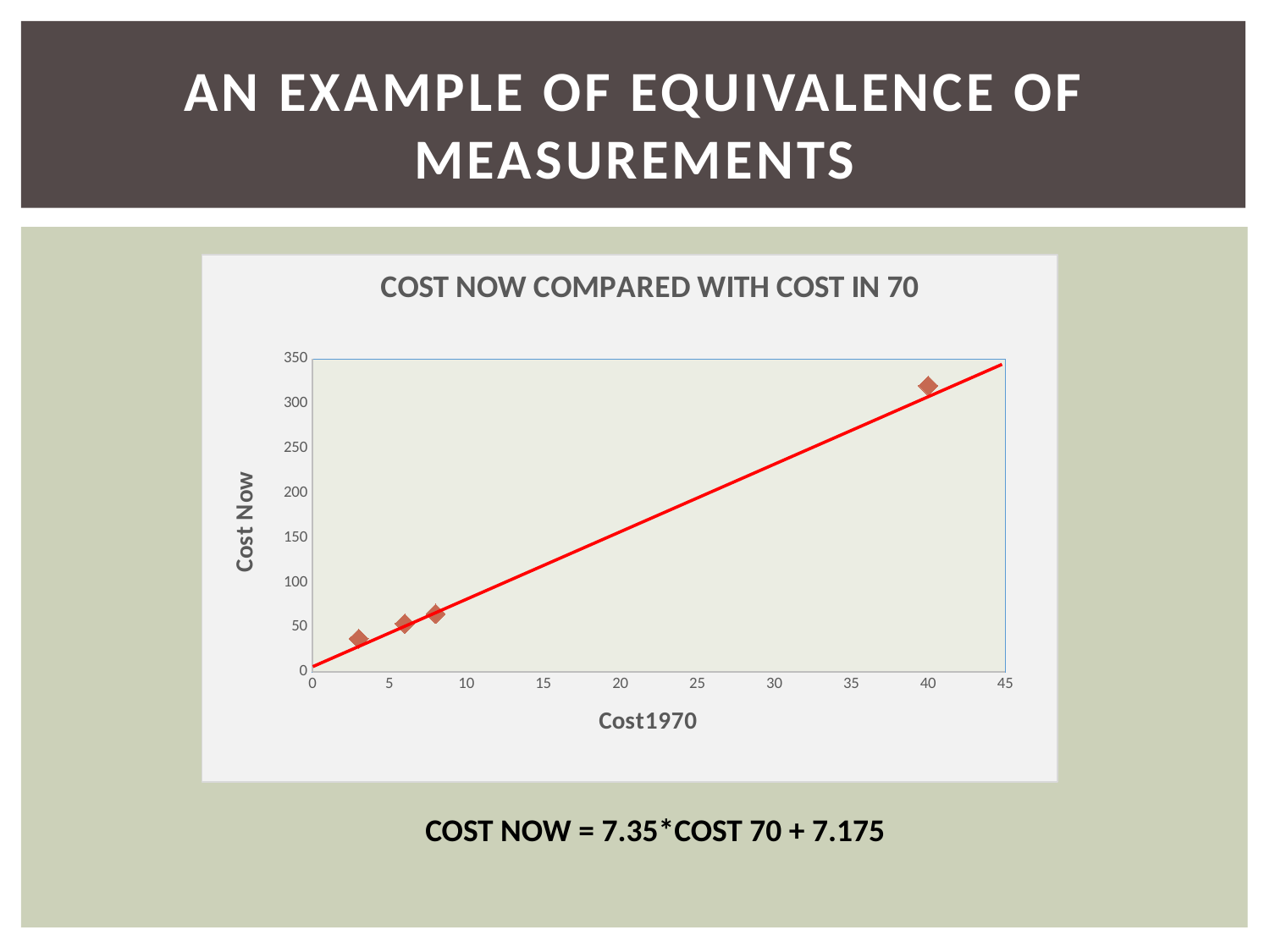
Is the Cost Now value for the point with the smallest Cost1970 greater or less than 50? less What kind of chart is shown on the slide? scatter chart Is the Cost1970 value of the rightmost data point greater or less than 35? greater Do the Cost Now values rise or fall as Cost1970 increases? rise Is the Cost Now value for the point with the largest Cost1970 greater or less than 350? less What is the label on the horizontal axis of the chart? Cost1970 What is the title of the chart? COST NOW COMPARED WITH COST IN 70 Which has the larger Cost Now value: the point with the largest Cost1970 or the point with the smallest Cost1970? the point with the largest Cost1970 How many data points are plotted on the chart? 4